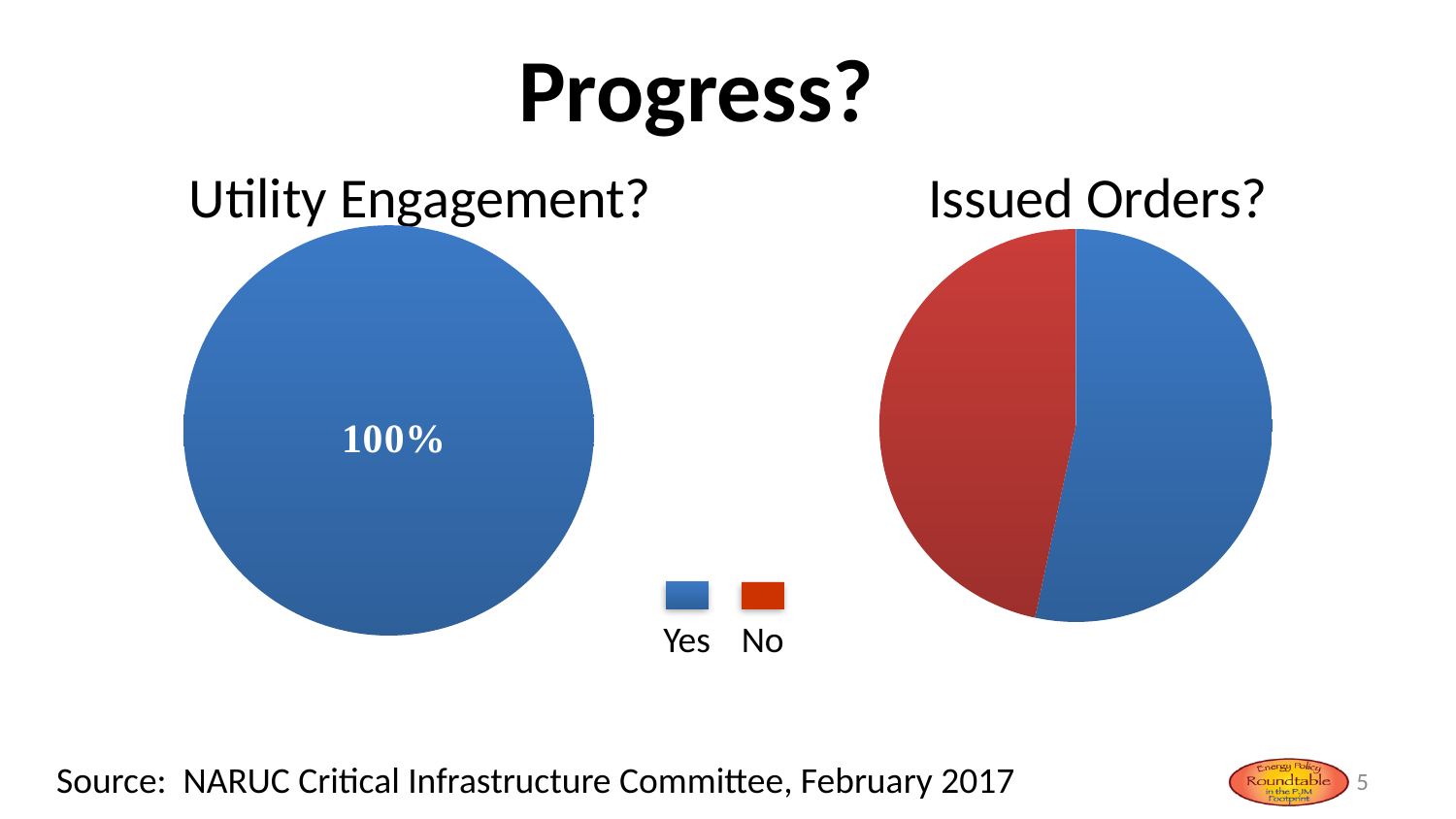
In the "Utility Engagement?" chart, which category makes up the entire pie? Yes What colour represents "No" in the legend? red In the "Issued Orders?" chart, which slice is larger, Yes or No? Yes In the "Issued Orders?" chart, which category has the smallest slice? No In the "Utility Engagement?" chart, what share of the pie is labelled on the slice? 100% What are the two entries in the legend? Yes and No How many slices does the "Utility Engagement?" pie chart show? 1 What kind of chart is the "Utility Engagement?" chart? pie chart How many slices does the "Issued Orders?" pie chart have? 2 How many entries does the legend list? 2 What kind of chart is the "Issued Orders?" chart? pie chart